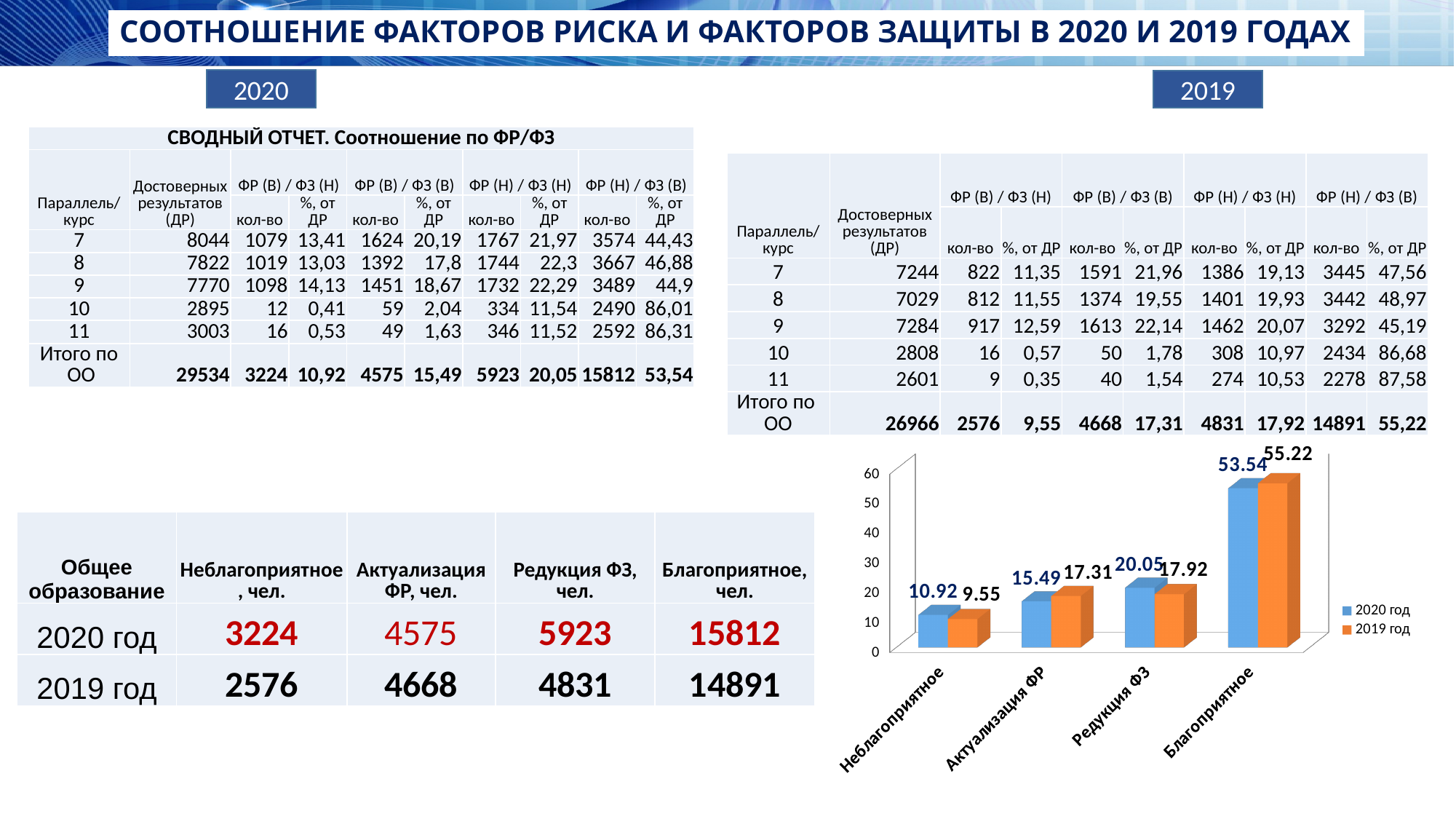
What is the value for Актуализация ФР in the 2019 год series? 17.31 Which category has the highest value in the 2020 год series? Благоприятное For Редукция ФЗ, which series has the larger value, 2020 год or 2019 год? 2020 год What is the value for Редукция ФЗ in the 2020 год series? 20.05 How many series does the chart legend list? 2 Which series is shown in orange in the chart? 2019 год What kind of chart is shown on the slide? bar chart What is the value for Неблагоприятное in the 2020 год series? 10.92 What is the value for Благоприятное in the 2019 год series? 55.22 What is the difference between the 2019 год and 2020 год values for Благоприятное? 1.68 Which category has the lowest value in the 2019 год series? Неблагоприятное How many categories are shown on the x axis of the chart? 4